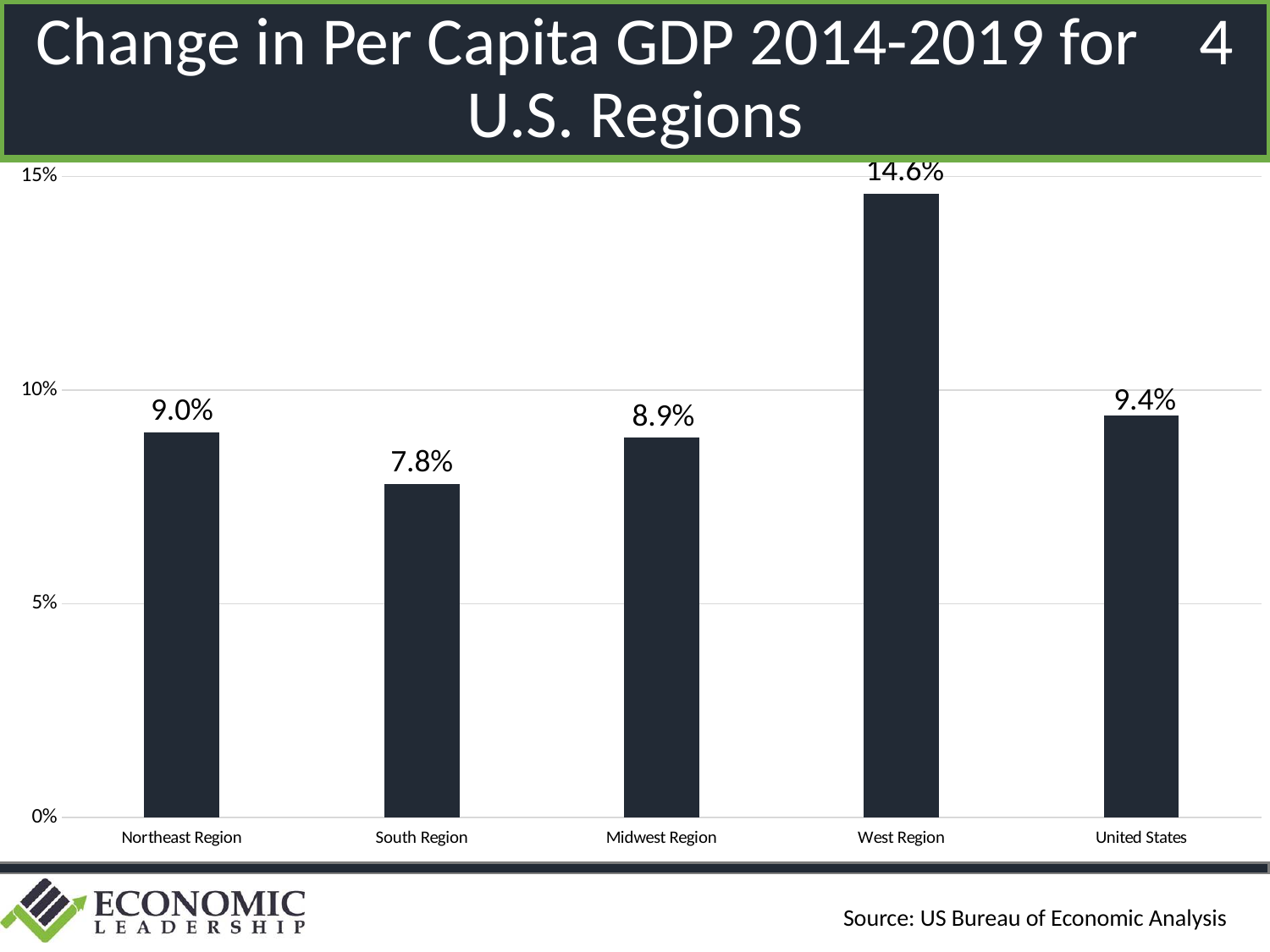
What is the difference between the United States value and the Northeast Region value? 0.4% Which is larger, the value for the Northeast Region or the South Region? Northeast Region What kind of chart is shown on the slide? Bar chart What is the difference between the West Region and the South Region values? 6.8% How many categories are shown on the x axis? 5 What is the change in per capita GDP for the South Region? 7.8% Which category has the highest change in per capita GDP? West Region What is the change in per capita GDP for the West Region? 14.6% What is the value shown for the United States? 9.4% Which category has the lowest change in per capita GDP? South Region What is the value shown for the Midwest Region? 8.9% Is the value for the West Region greater or less than 10%? greater